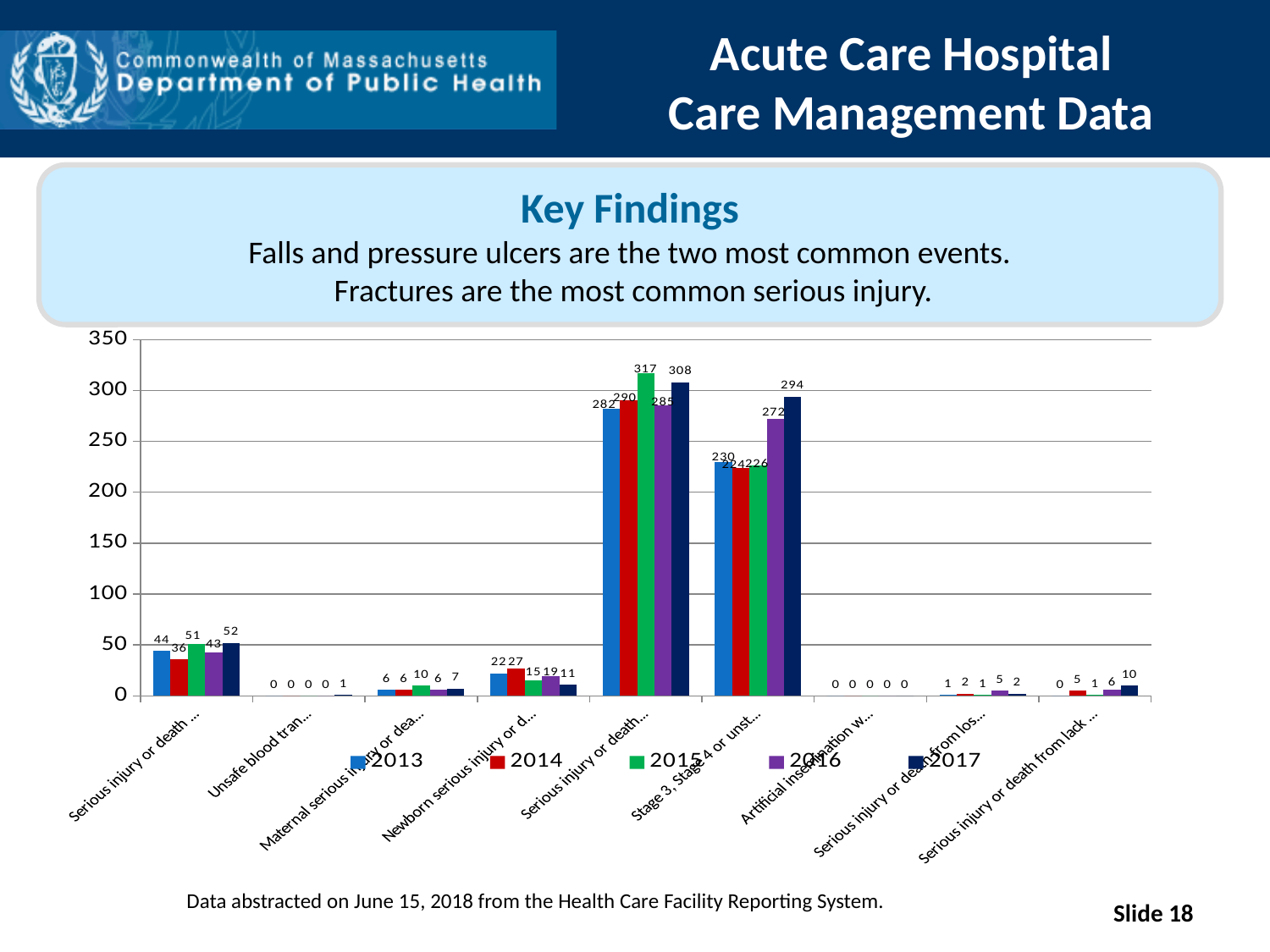
Which years are listed in the legend? 2013, 2014, 2015, 2016, 2017 In the category 'Stage 3, Stage 4 or unst...', which is larger, the 2016 value or the 2014 value? 2016 What kind of chart is shown on the slide? bar chart How many series does the legend list? 5 What is the 2017 value for the category labelled 'Stage 3, Stage 4 or unst...'? 294 What is the 2017 value for the last category, 'Serious injury or death from lack ...'? 10 What is the difference between the 2015 and 2013 values in the fifth category (the tallest group of bars)? 35 What is the 2015 value for the fifth category (the tallest group of bars)? 317 Which year has the lowest value in the category 'Newborn serious injury or d...'? 2017 How many categories are shown along the x axis? 9 What is the 2013 value for the first category, 'Serious injury or death ...'? 44 Which year has the highest value in the fifth category (the tallest group of bars)? 2015